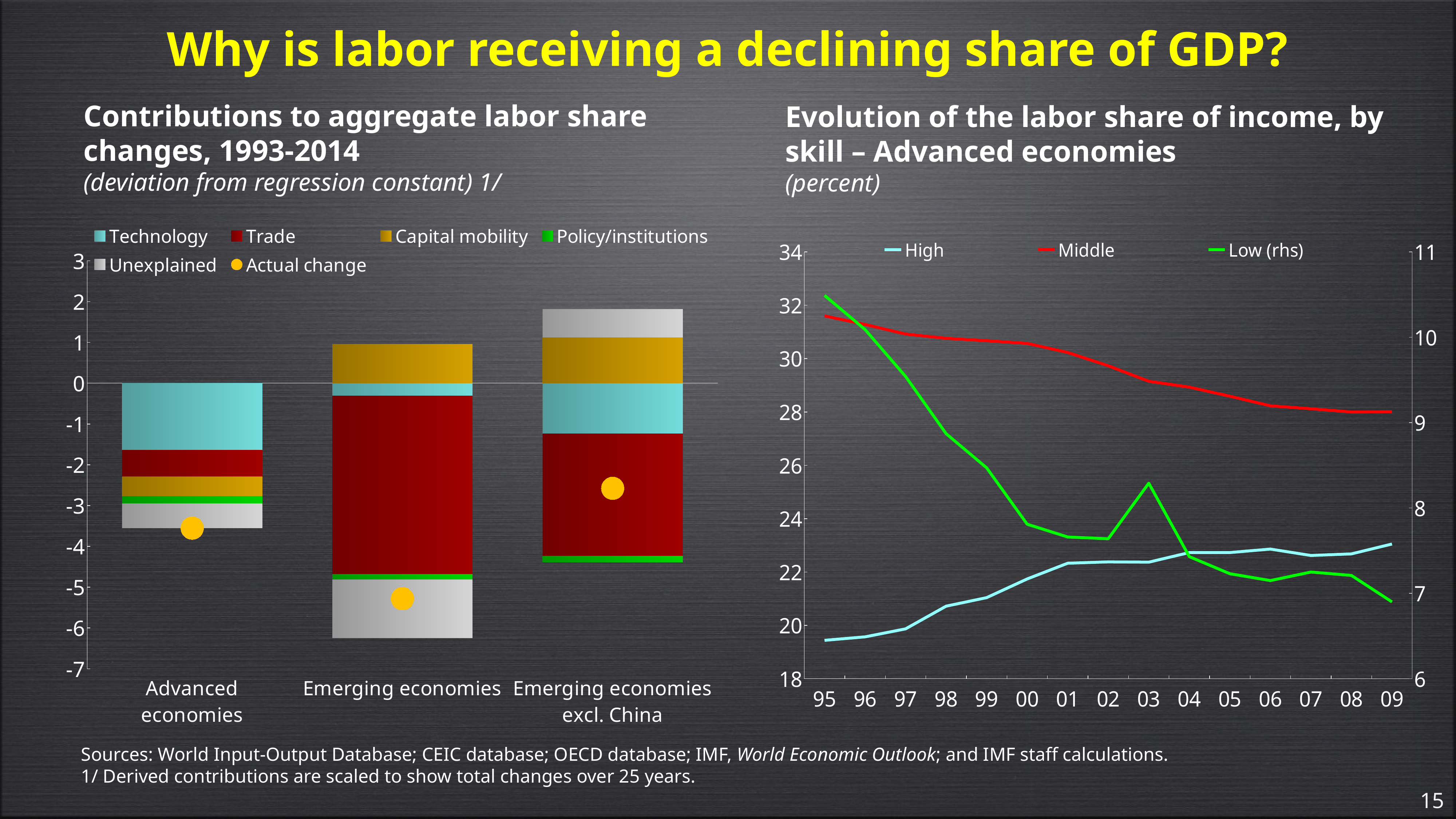
In the left chart, which category has the lowest 'Actual change' value? Emerging economies What kind of chart is the right chart, 'Evolution of the labor share of income, by skill – Advanced economies'? line chart In the left chart, is the 'Actual change' value for Advanced economies greater or less than -3? less In the right chart, is the 'High' value in 95 greater or less than 20? less In the right chart, which series is plotted on the right-hand axis? Low (rhs) What kind of chart is the left chart, 'Contributions to aggregate labor share changes, 1993-2014'? stacked bar chart In the left chart, is the 'Actual change' value for Emerging economies greater or less than -5? less In the left chart, which is larger: the 'Actual change' for Advanced economies or for Emerging economies excl. China? Emerging economies excl. China In the left chart, how many categories are shown on the x axis? 3 In the right chart, does the 'High' series rise or fall from 95 to 09? rise In the right chart, how many series does the legend list? 3